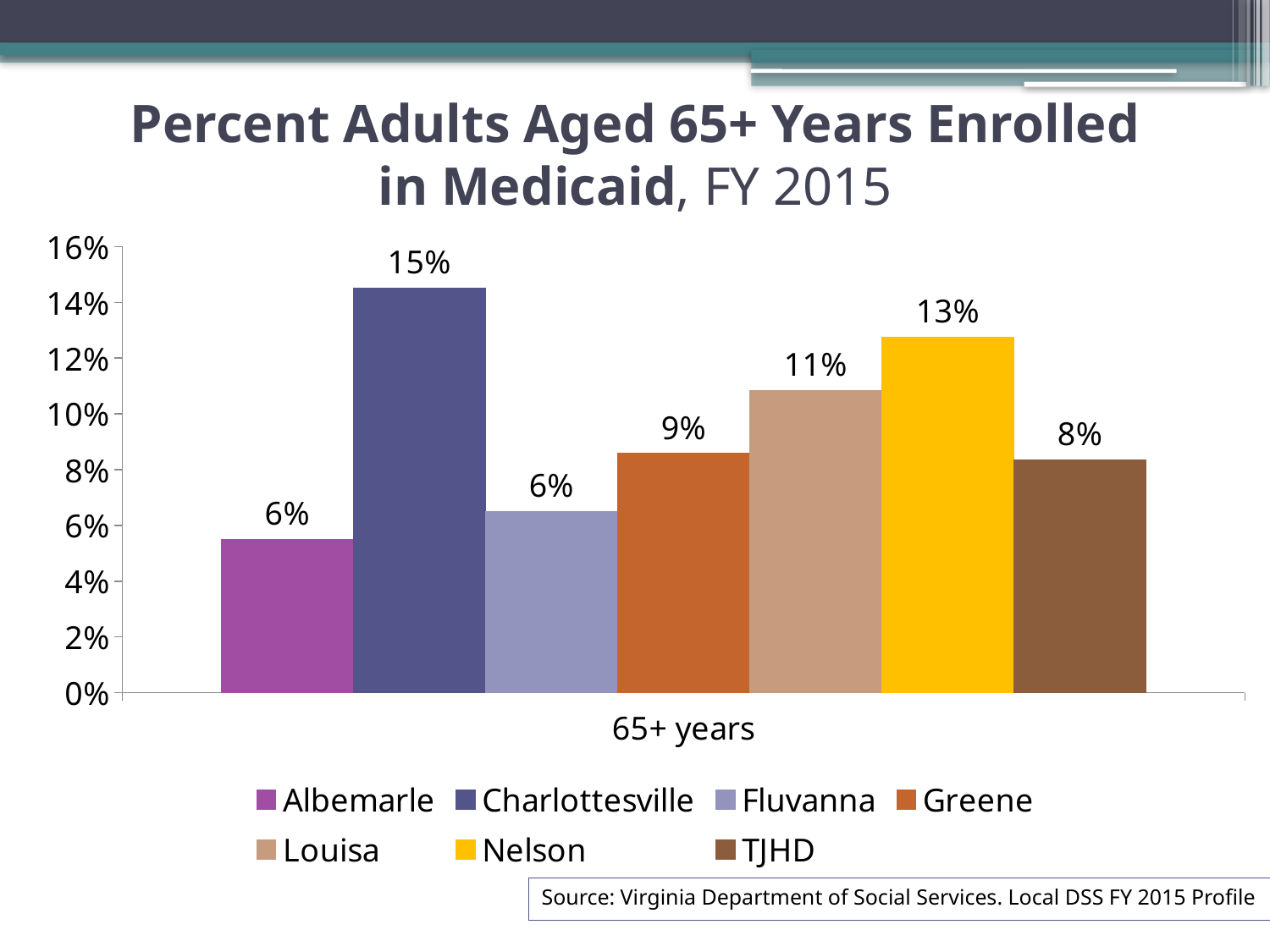
What is the value for TJHD? 8% What kind of chart is shown on the slide? Bar chart Which is larger, the value for Nelson or the value for TJHD? Nelson What is the value for Greene? 9% What is the value for Nelson? 13% Is the value for Charlottesville greater or less than 14%? greater What is the value for Louisa? 11% Which locality has the highest percent of adults aged 65+ enrolled in Medicaid? Charlottesville What is the title of the chart? Percent Adults Aged 65+ Years Enrolled in Medicaid, FY 2015 How many series does the legend list? 7 What is the value for Charlottesville? 15% Which is larger, the value for Louisa or the value for Greene? Louisa